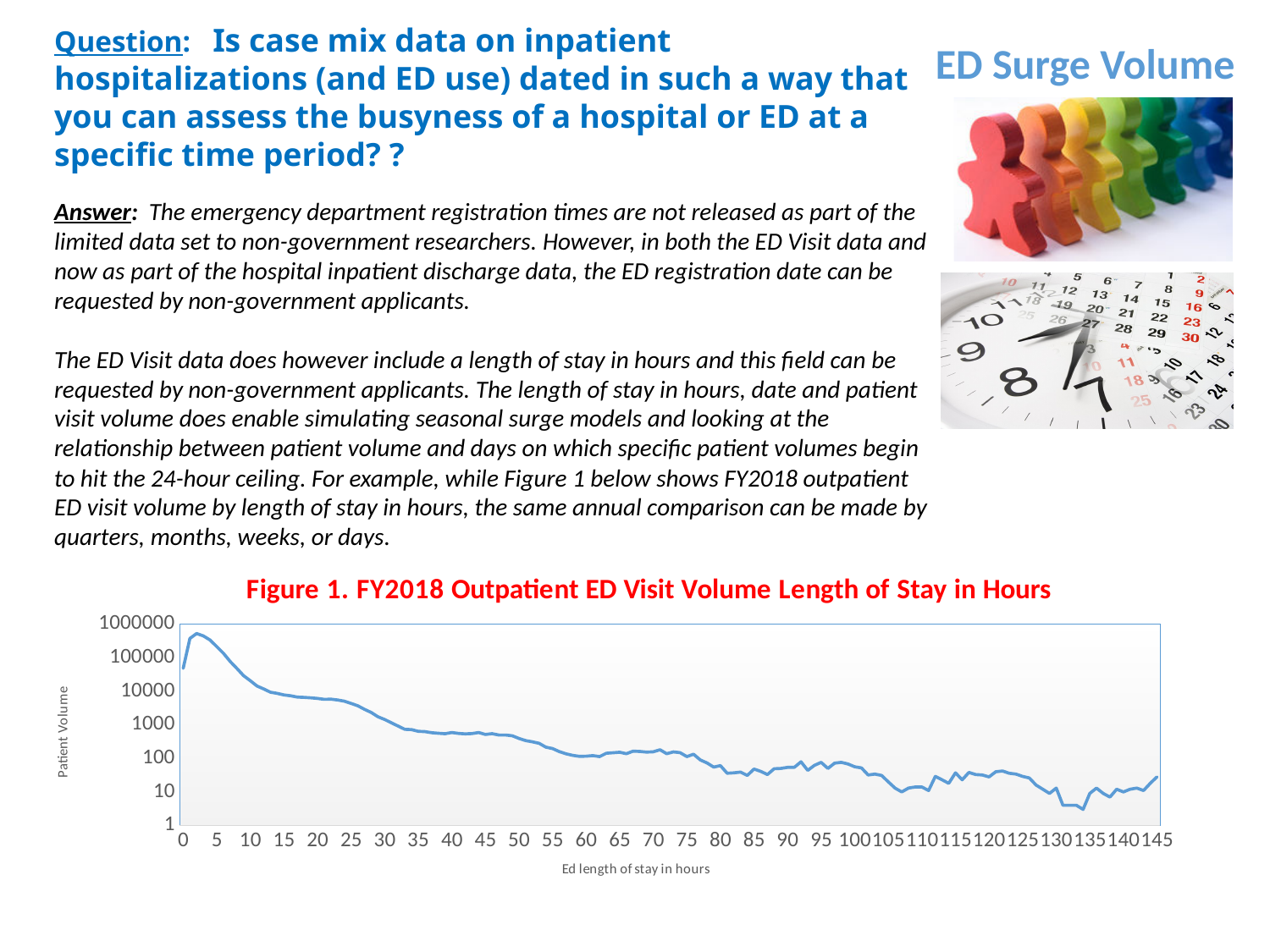
What is the title of the chart on the slide? Figure 1. FY2018 Outpatient ED Visit Volume Length of Stay in Hours In Figure 1, is the patient volume at 20 hours greater or less than 1000? greater In Figure 1, which has the larger patient volume: a length of stay of 50 hours or 130 hours? 50 hours In Figure 1, is the patient volume at 40 hours greater or less than 1000? less In Figure 1, is the highest patient volume found near the start or near the end of the x axis? near the start In Figure 1, which has the larger patient volume: a length of stay of 10 hours or 100 hours? 10 hours In Figure 1, does patient volume generally rise or fall as ED length of stay in hours increases beyond the early peak? fall What is the label of the y axis in Figure 1? Patient Volume In Figure 1, is the peak patient volume greater or less than 100000? greater What kind of chart is Figure 1? line chart